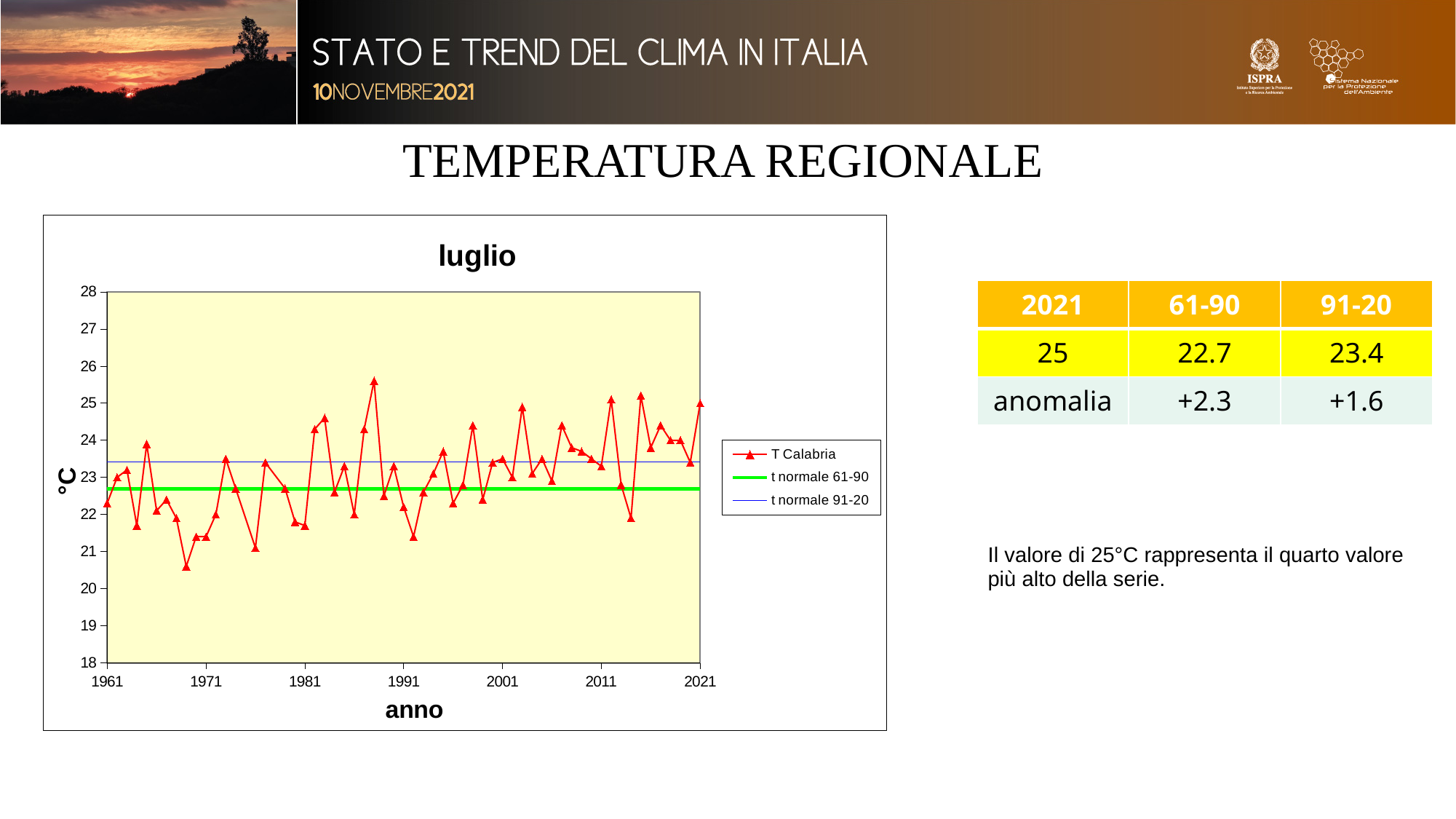
What is the value of the t normale 61-90 line? 22.7 Is the T Calabria value for 2021 greater or less than 24? greater What is the label of the x axis of the chart? anno What is the title of the chart? luglio By how much does the 2021 value exceed the t normale 61-90 value? +2.3 What is the value of the t normale 91-20 line? 23.4 Which is larger, the T Calabria value for 2021 or the t normale 91-20 value? T Calabria value for 2021 What kind of chart is shown on the slide? line chart How many series does the legend of the chart list? 3 By how much does the 2021 value exceed the t normale 91-20 value? +1.6 What is the T Calabria value for 2021 in the chart? 25 Is the T Calabria value for 1961 greater or less than 23? less